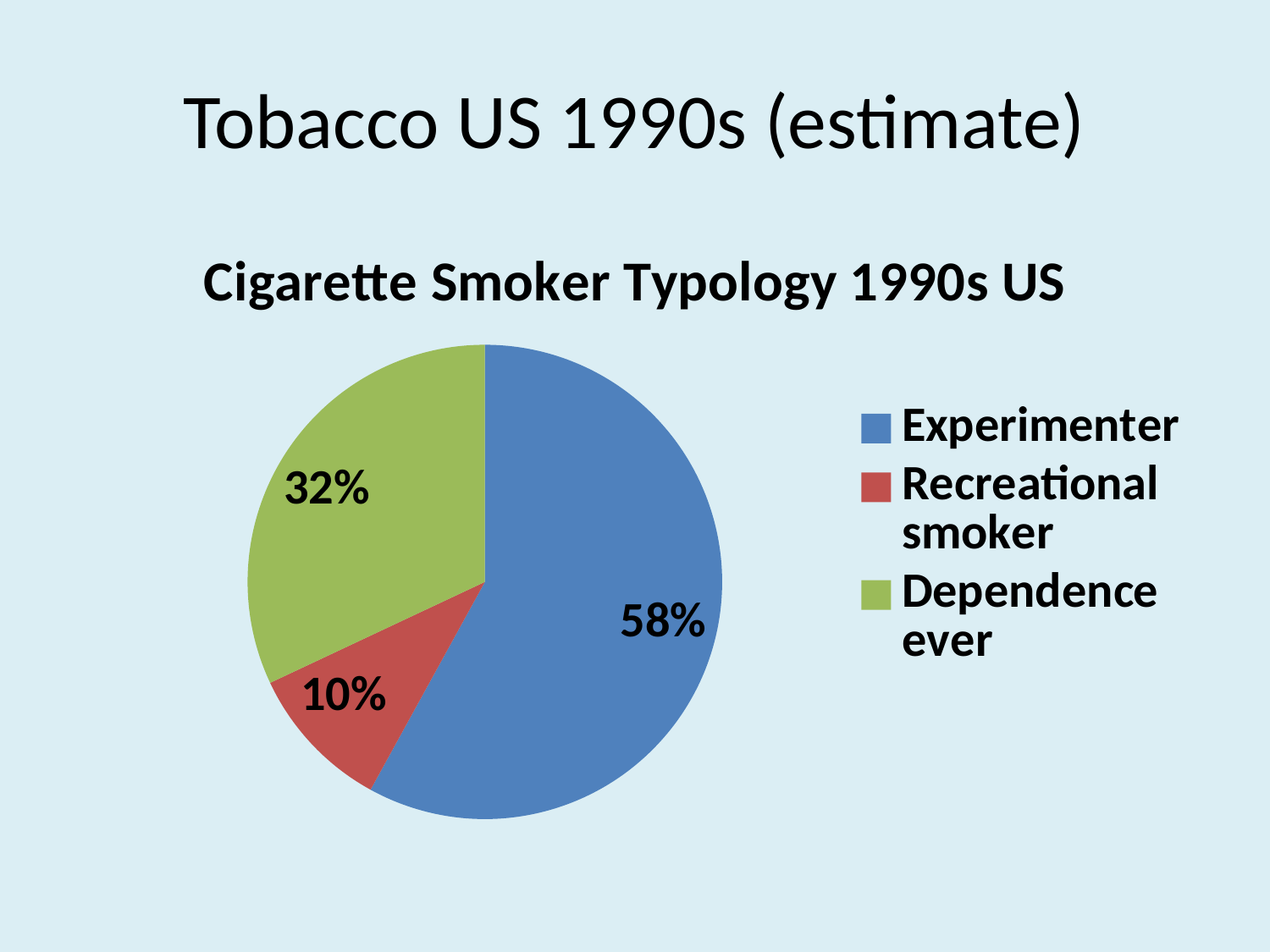
Which is larger, the Dependence ever slice or the Recreational smoker slice? Dependence ever How many categories are shown in the pie chart? 3 What is the title of the chart? Cigarette Smoker Typology 1990s US What share of the pie does Dependence ever account for? 32% What is the difference in percentage points between the Experimenter and Dependence ever slices? 26 What kind of chart is shown on the slide? Pie chart What share of the pie does Experimenter account for? 58% Which category has the smallest slice of the pie? Recreational smoker Which category has the largest slice of the pie? Experimenter What is the difference in percentage points between the Dependence ever and Recreational smoker slices? 22 Which colour represents Dependence ever in the legend? Green What share of the pie does Recreational smoker account for? 10%